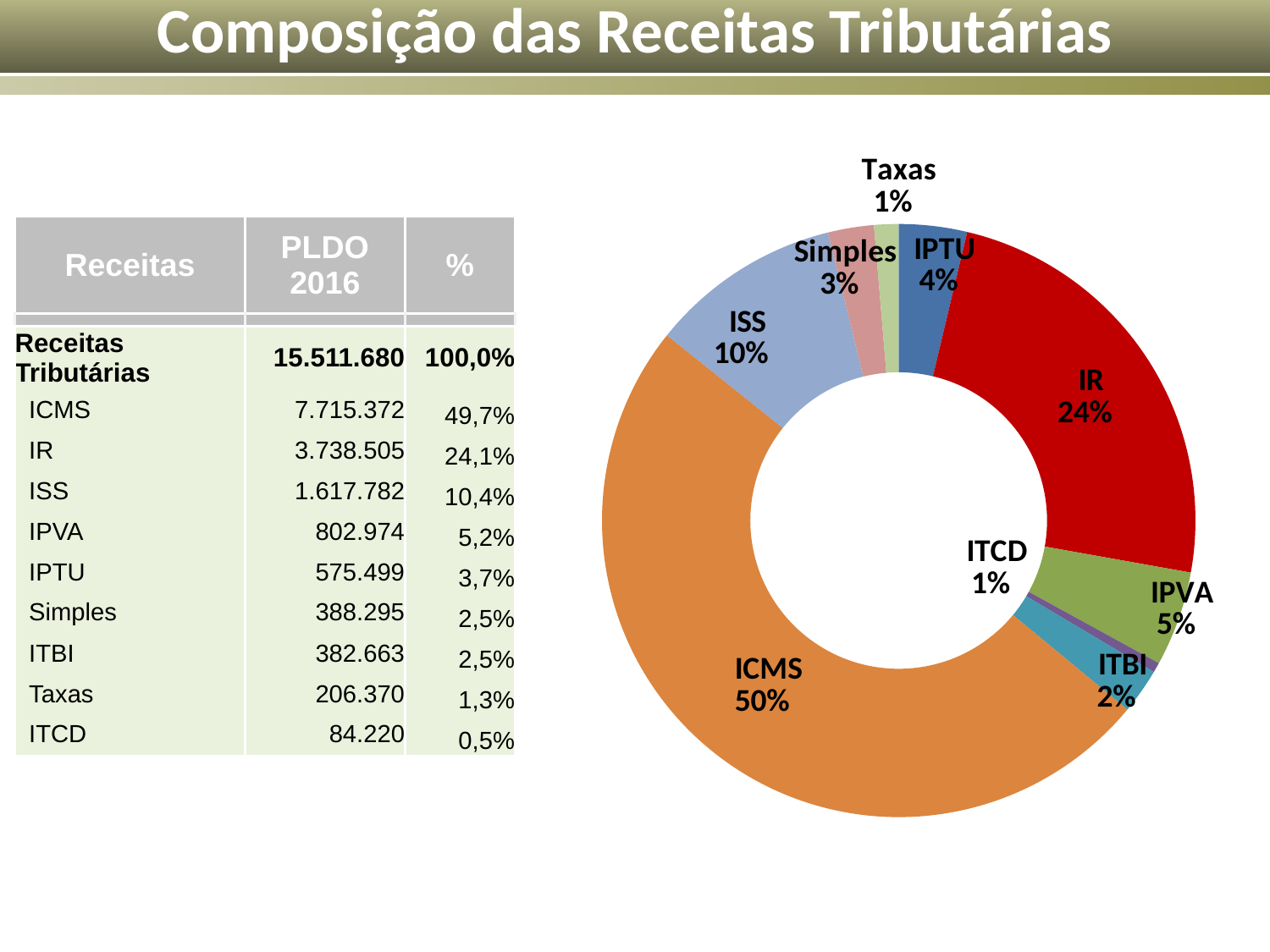
What percentage is shown for ITCD in the pie chart? 1% What percentage is shown for ISS in the pie chart? 10% What percentage is shown for Simples in the pie chart? 3% What percentage is shown for IR in the pie chart? 24% What colour is the ICMS slice in the pie chart? Orange How many slices does the pie chart have? 9 What percentage is shown for IPVA in the pie chart? 5% What kind of chart is shown on the slide? Pie chart (doughnut) Which slice is larger in the pie chart, IPTU or ITBI? IPTU What share of the pie chart does ICMS represent? 50% Which category has the largest slice in the pie chart? ICMS What is the difference in percentage points between the ICMS and IR slices? 26